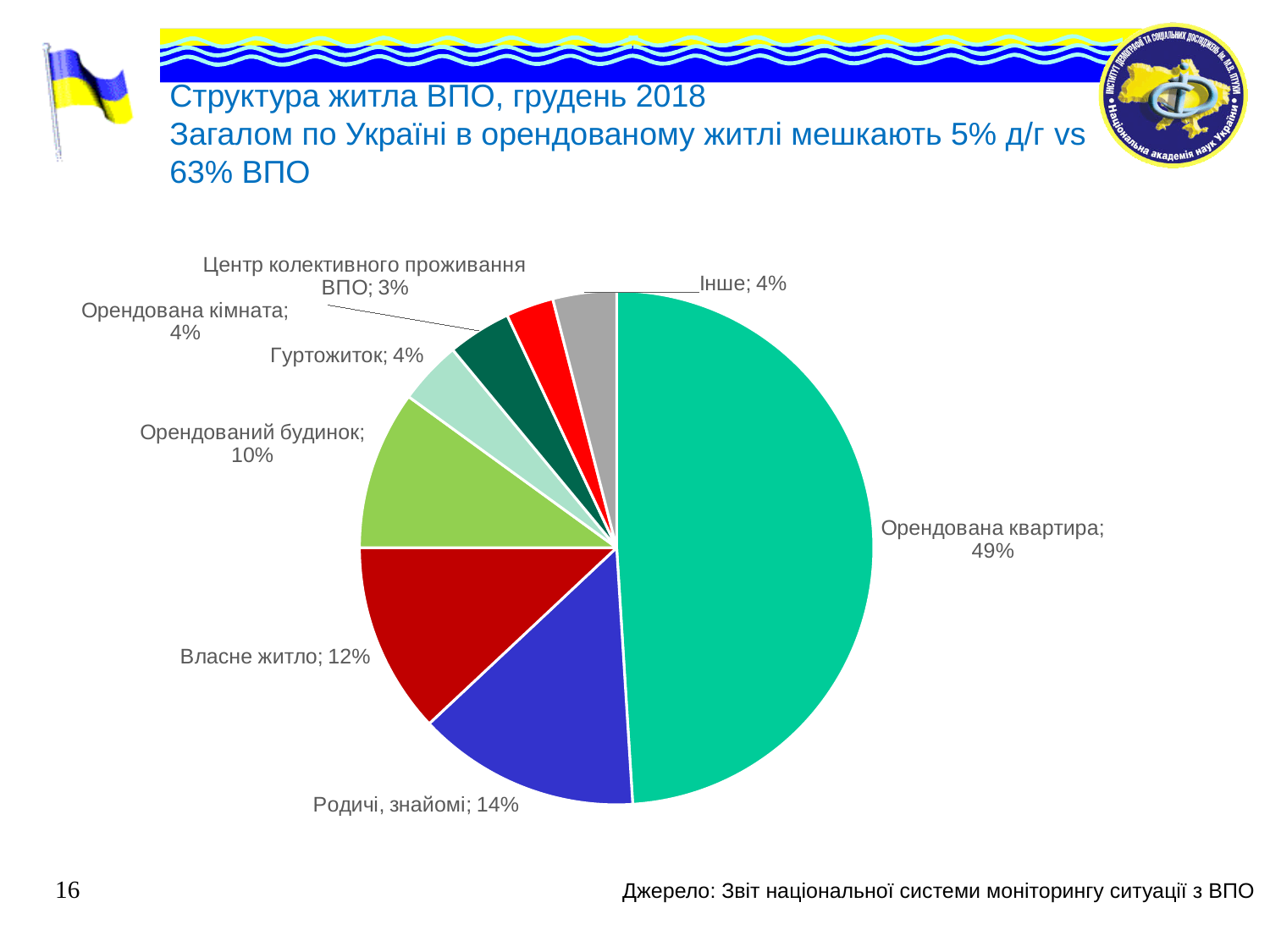
How many slices does the pie chart have? 8 Which is larger, "Власне житло" or "Орендований будинок"? Власне житло What is the title of the chart on the slide? Структура житла ВПО, грудень 2018 What is the value for "Центр колективного проживання ВПО"? 3% What is the value for "Орендований будинок"? 10% What is the value for "Родичі, знайомі"? 14% What is the value for "Власне житло"? 12% What share of the pie does "Орендована квартира" take? 49% Which category has the smallest slice of the pie? Центр колективного проживання ВПО Which category has the largest slice of the pie? Орендована квартира What is the difference in percentage points between "Орендована квартира" and "Родичі, знайомі"? 35 What kind of chart is shown on the slide? pie chart